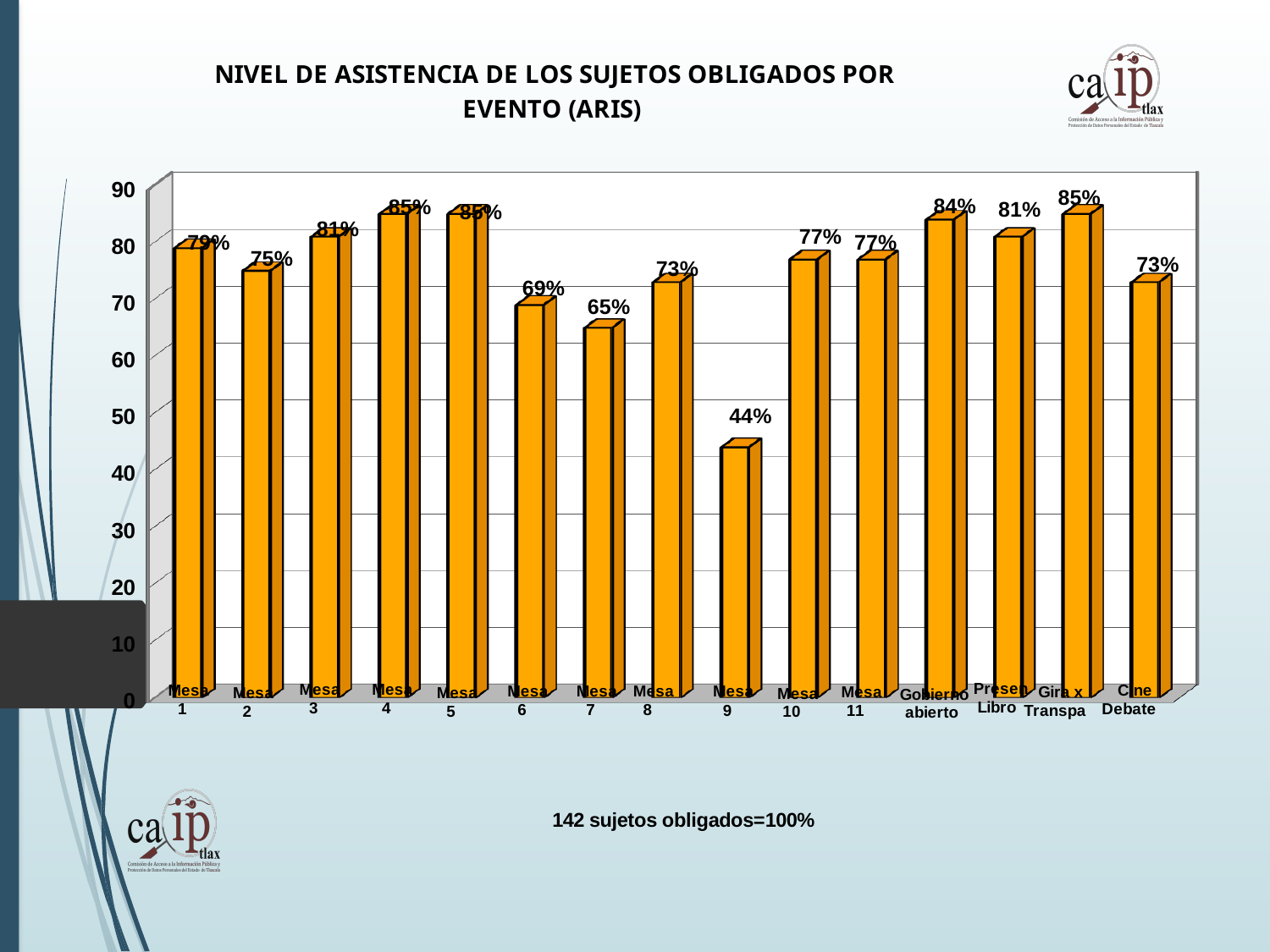
What kind of chart is shown on the slide? bar chart What is the attendance value for Mesa 9? 44% What is the value shown for Mesa 7? 65% How many events (categories) are shown on the x axis? 15 Which event has the lowest attendance level? Mesa 9 What is the difference between the values for Mesa 10 and Mesa 9? 33 percentage points Is the value for Mesa 2 greater or less than 70? greater Which has a higher value, Mesa 6 or Mesa 8? Mesa 8 What is the title of the chart? NIVEL DE ASISTENCIA DE LOS SUJETOS OBLIGADOS POR EVENTO (ARIS) What is the value shown for Cine Debate? 73% What is the value shown for Gobierno abierto? 84% What is the difference between the values for Gira x Transpa and Cine Debate? 12 percentage points